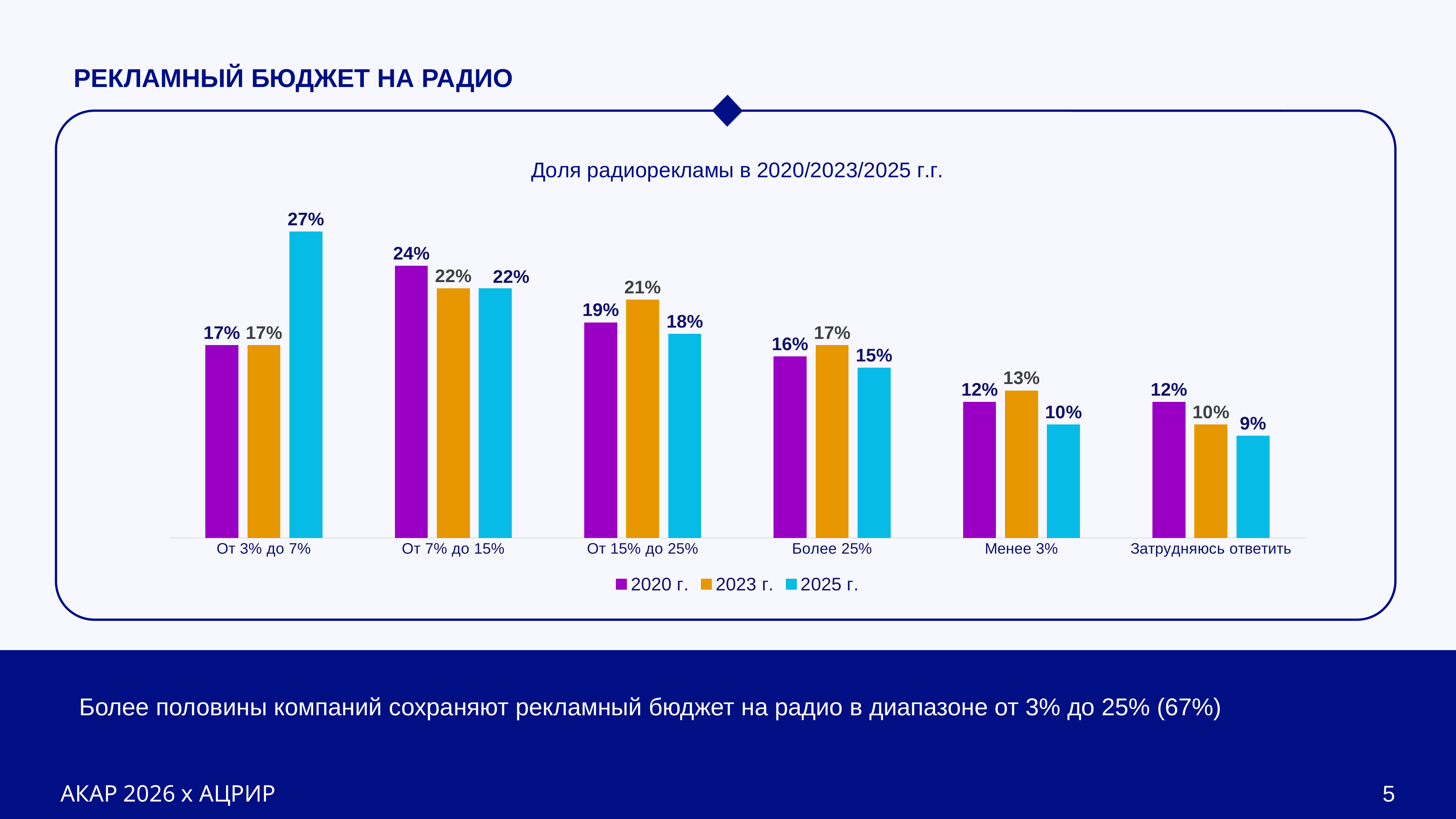
How many series does the legend list? 3 What is the value for 2023 г. in the category 'От 15% до 25%'? 21% Which category has the highest value for the 2025 г. series? От 3% до 7% How many categories are shown on the x axis? 6 What is the difference between the 2025 г. and 2020 г. values in the category 'От 3% до 7%'? 10% What is the value for 2020 г. in the category 'От 7% до 15%'? 24% What is the value for 2025 г. in the category 'От 3% до 7%'? 27% What is the value for 2025 г. in the category 'Затрудняюсь ответить'? 9% What is the title of the chart? Доля радиорекламы в 2020/2023/2025 г.г. What kind of chart is shown on the slide? Bar chart Which category has the lowest value for the 2023 г. series? Затрудняюсь ответить Which is larger in the category 'Более 25%': the value for 2023 г. or the value for 2025 г.? 2023 г.